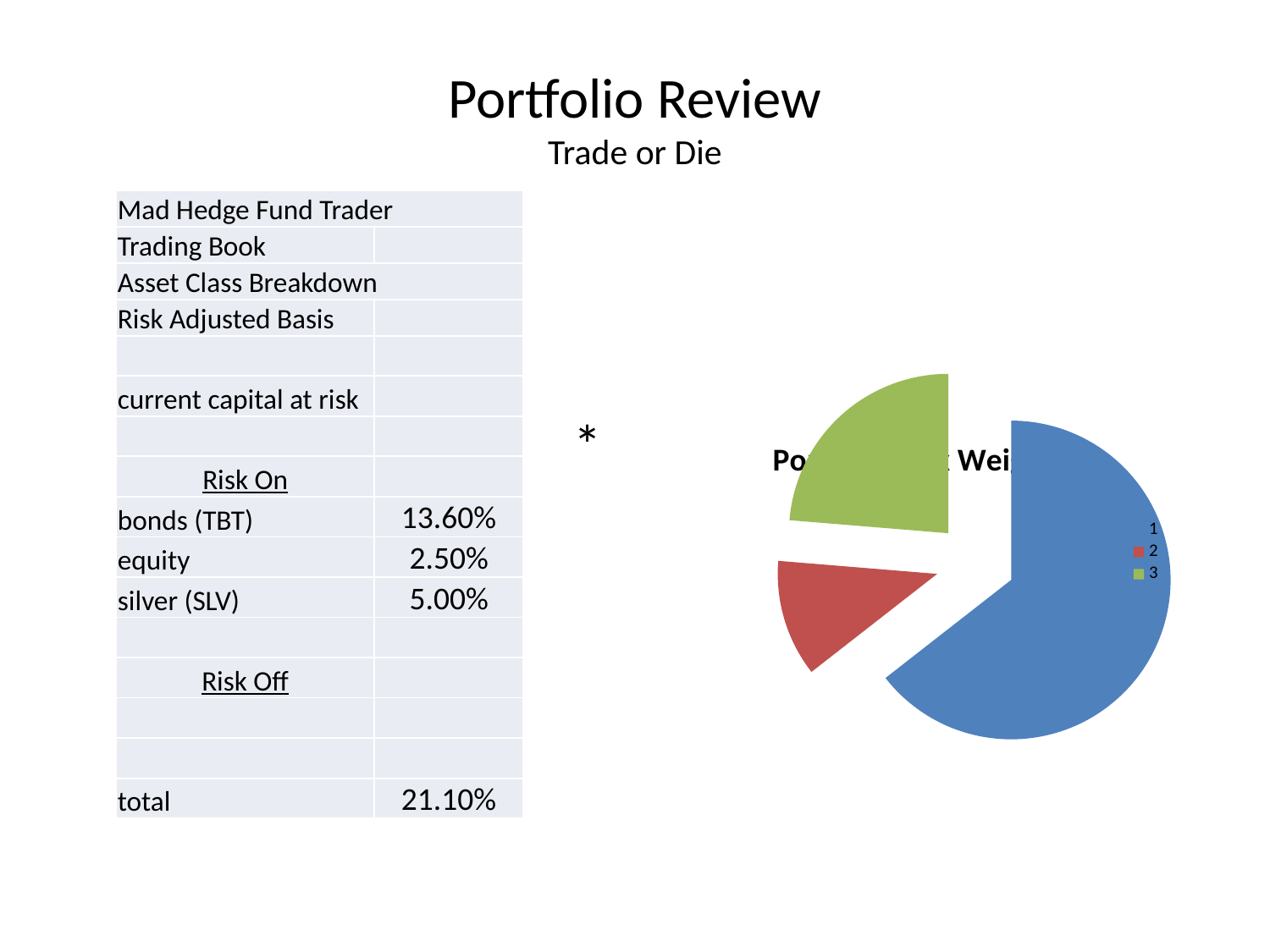
What colour is slice 1 in the pie chart? blue How many slices does the pie chart have? 3 What colour is slice 3 in the pie chart? green Which slice of the pie chart is the smallest? 2 In the pie chart, which is larger, slice 1 or slice 3? 1 In the pie chart, which is larger, slice 2 or slice 3? 3 Which slice of the pie chart is the largest? 1 What kind of chart is shown on the slide? pie chart How many entries does the pie chart's legend list? 3